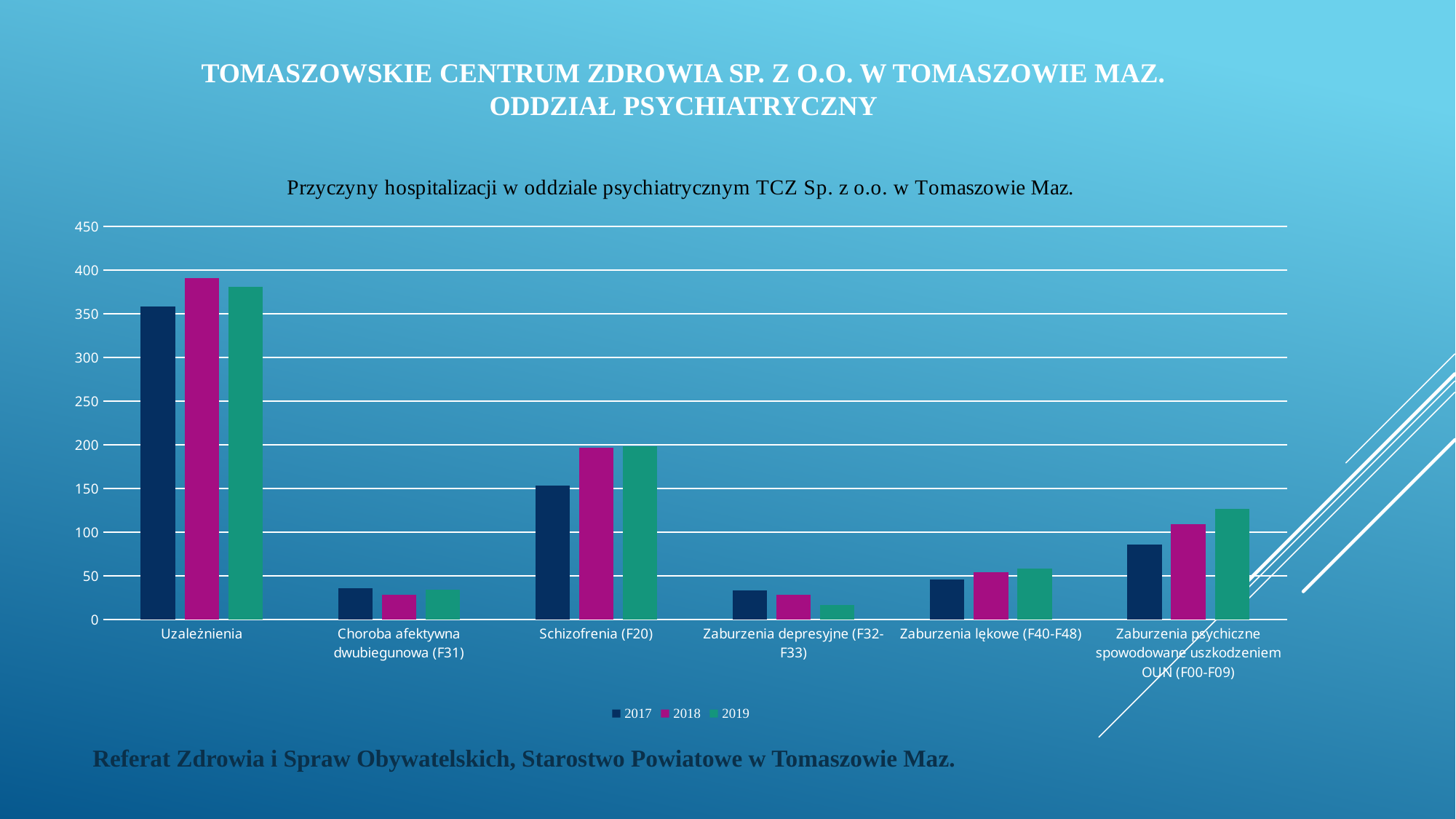
Do the values for Zaburzenia psychiczne spowodowane uszkodzeniem OUN (F00-F09) rise or fall from 2017 to 2019? rise Which category has the lowest value for 2019? Zaburzenia depresyjne (F32-F33) How many series does the legend list? 3 Is the 2017 value for Uzależnienia greater or less than 300? greater For Schizofrenia (F20), which year has the larger value, 2017 or 2018? 2018 How many diagnosis categories are shown on the x axis? 6 Is the 2019 value for Zaburzenia lękowe (F40-F48) greater or less than 100? less What kind of chart is shown on the slide? bar chart Do the values for Zaburzenia depresyjne (F32-F33) rise or fall from 2017 to 2019? fall Which category has the highest value for 2017? Uzależnienia Is the 2018 value for Schizofrenia (F20) greater or less than 150? greater What is the title of the chart? Przyczyny hospitalizacji w oddziale psychiatrycznym TCZ Sp. z o.o. w Tomaszowie Maz.